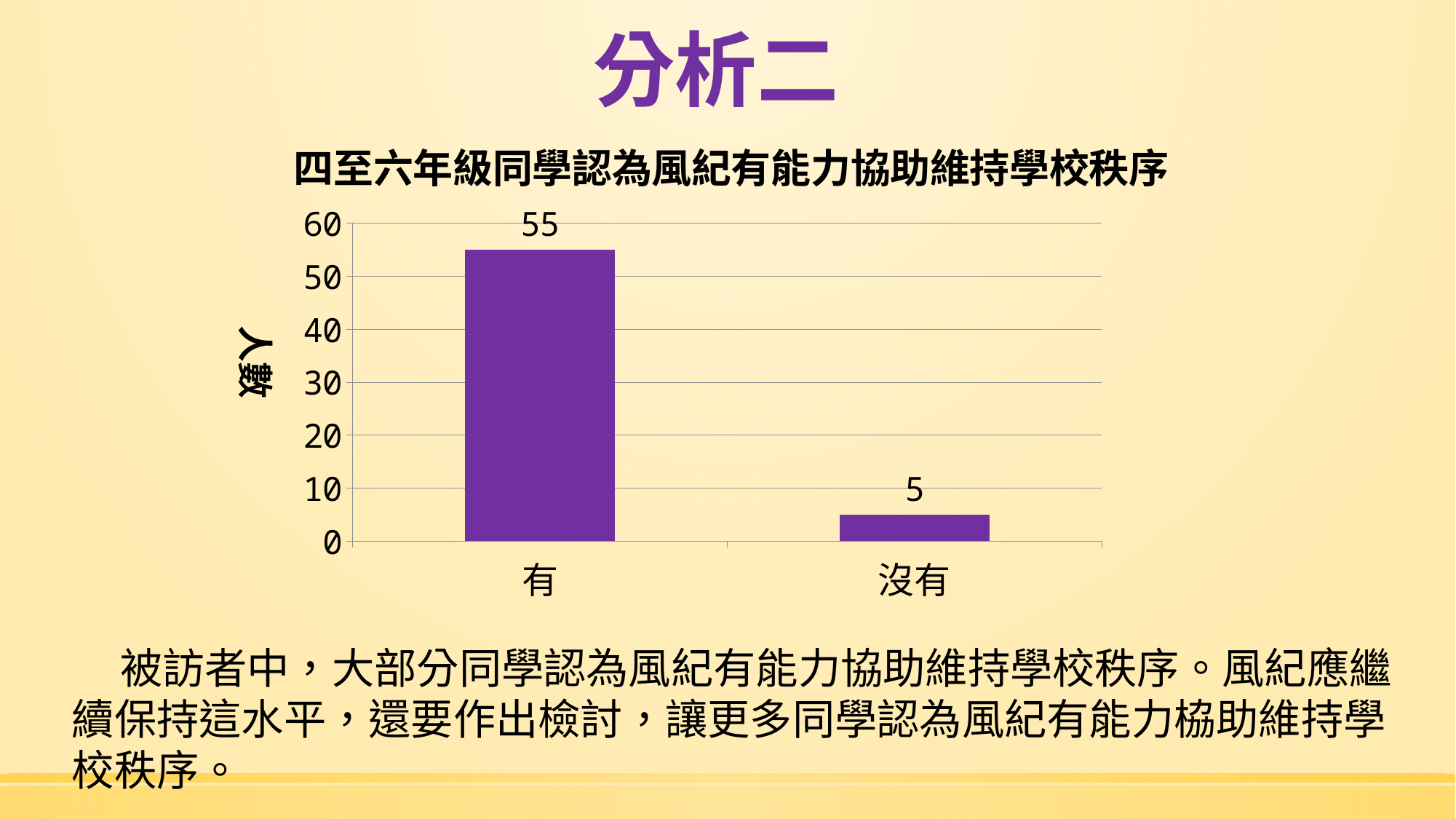
What is the difference between the values for 有 and 沒有? 50 How many categories are shown on the x axis? 2 What is the value for 有? 55 What kind of chart is shown on the slide? bar chart What is the label of the vertical axis? 人數 Is the value for 有 greater or less than 50? greater Is the value for 沒有 greater or less than 10? less Which category has the lowest value? 沒有 What is the value for 沒有? 5 Which is larger, the value for 有 or the value for 沒有? 有 Which category has the highest value? 有 What is the title of the chart? 四至六年級同學認為風紀有能力協助維持學校秩序